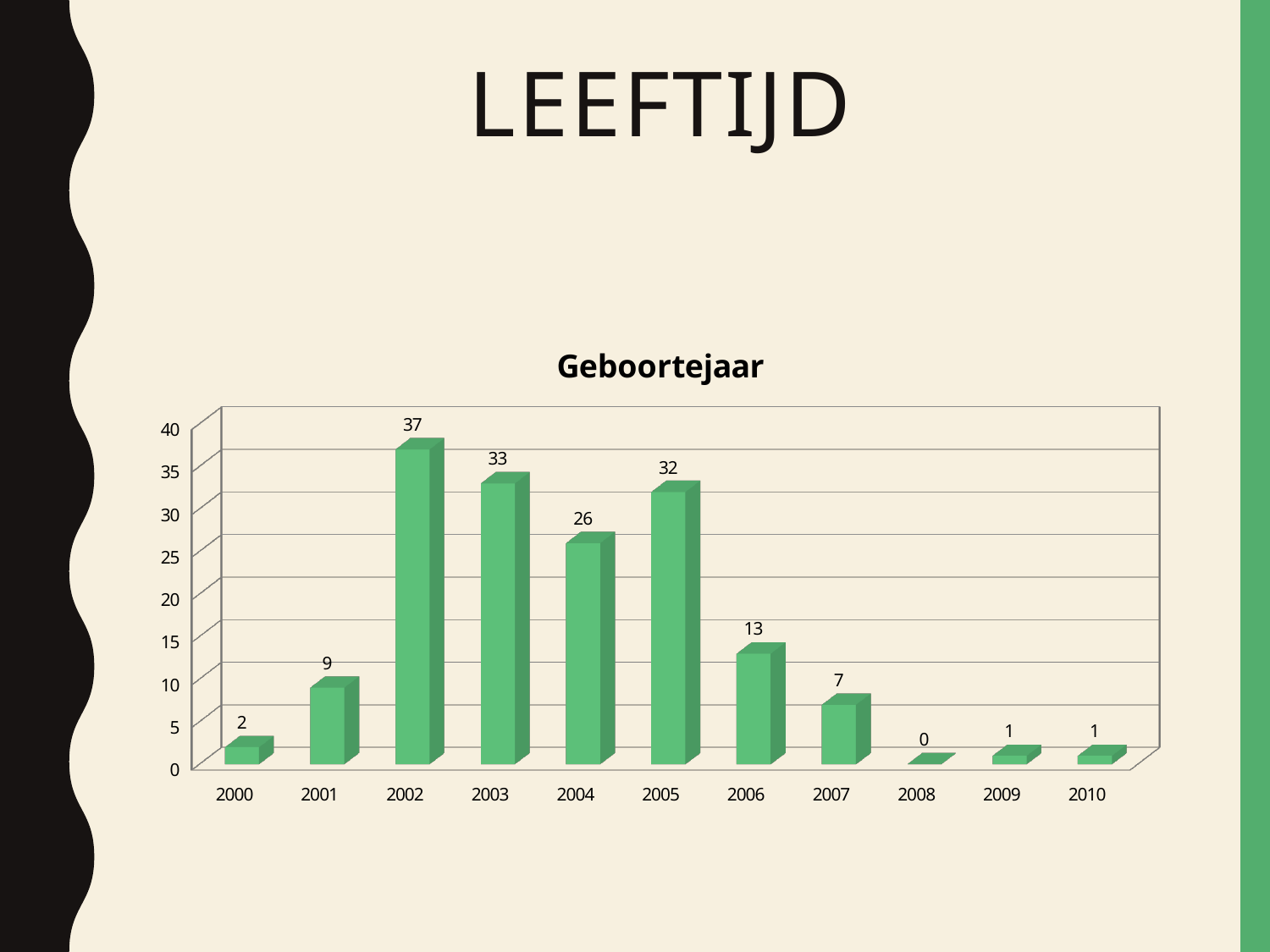
Is the value for 2004 greater or less than 25? greater How many years are shown on the x axis? 11 Which is larger, the value for 2003 or the value for 2005? 2003 What is the value for 2008? 0 Which year has the highest value? 2002 What is the value for 2002? 37 What is the difference between the values for 2002 and 2003? 4 What is the difference between the values for 2004 and 2006? 13 Which year has the lowest value? 2008 What is the title of the chart? Geboortejaar What kind of chart is this? bar chart What is the value for 2005? 32